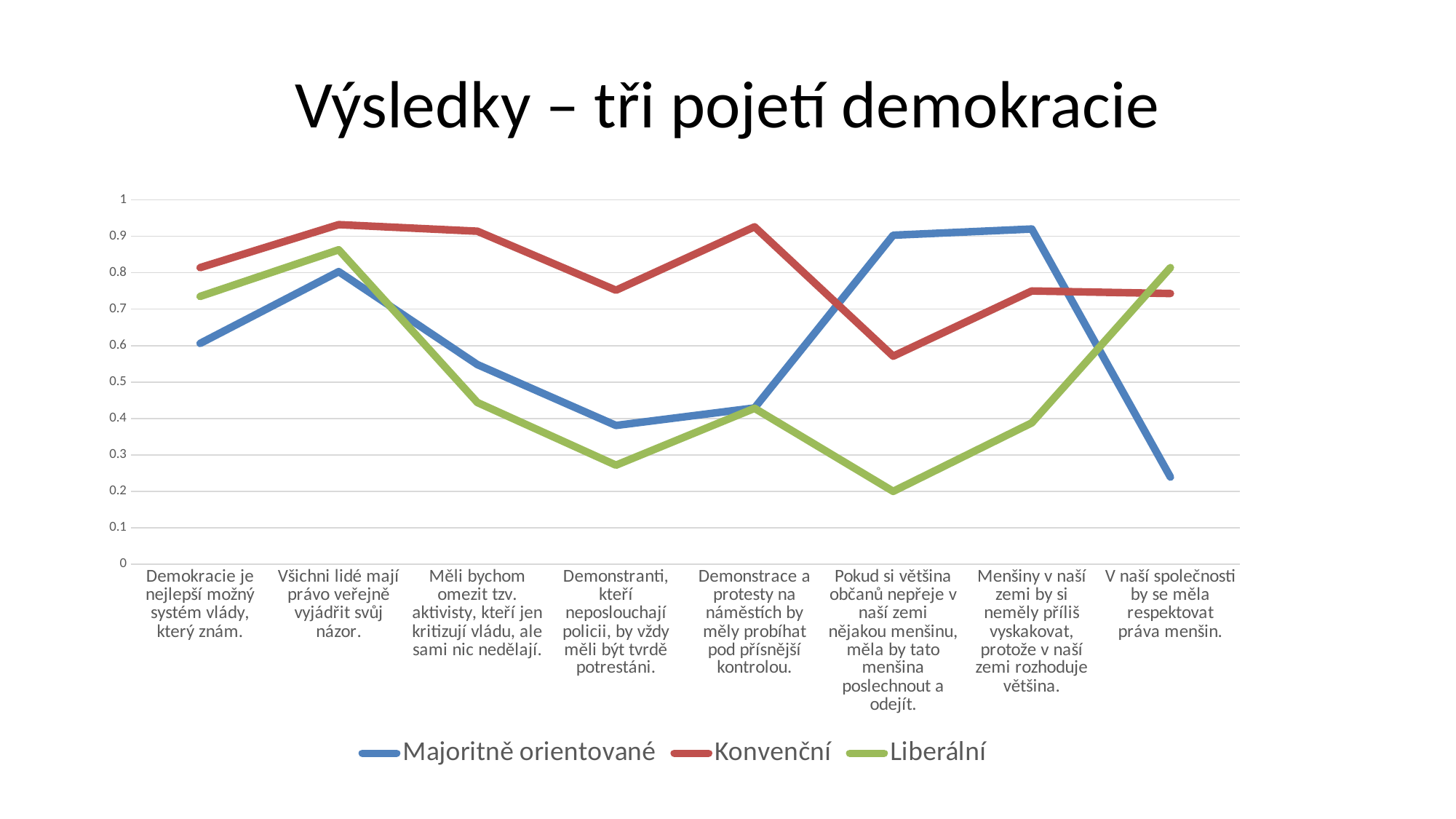
What kind of chart is shown on the slide? line chart Is the value for Majoritně orientované at "Pokud si většina občanů nepřeje v naší zemi nějakou menšinu, měla by tato menšina poslechnout a odejít." greater or less than 0.8? greater How many series does the legend list? 3 How many categories are plotted along the x axis? 8 At "Demokracie je nejlepší možný systém vlády, který znám.", which series has the larger value, Majoritně orientované or Liberální? Liberální Is the value for Konvenční at "Demonstrace a protesty na náměstích by měly probíhat pod přísnější kontrolou." greater or less than 0.8? greater What colour is the line for the Liberální series? green For the Konvenční series, which category has the lowest value? Pokud si většina občanů nepřeje v naší zemi nějakou menšinu, měla by tato menšina poslechnout a odejít. At "Demonstranti, kteří neposlouchají policii, by vždy měli být tvrdě potrestáni.", which series has the larger value, Konvenční or Liberální? Konvenční Is the value for Majoritně orientované at "V naší společnosti by se měla respektovat práva menšin." greater or less than 0.3? less For the Liberální series, which category has the lowest value? Pokud si většina občanů nepřeje v naší zemi nějakou menšinu, měla by tato menšina poslechnout a odejít.